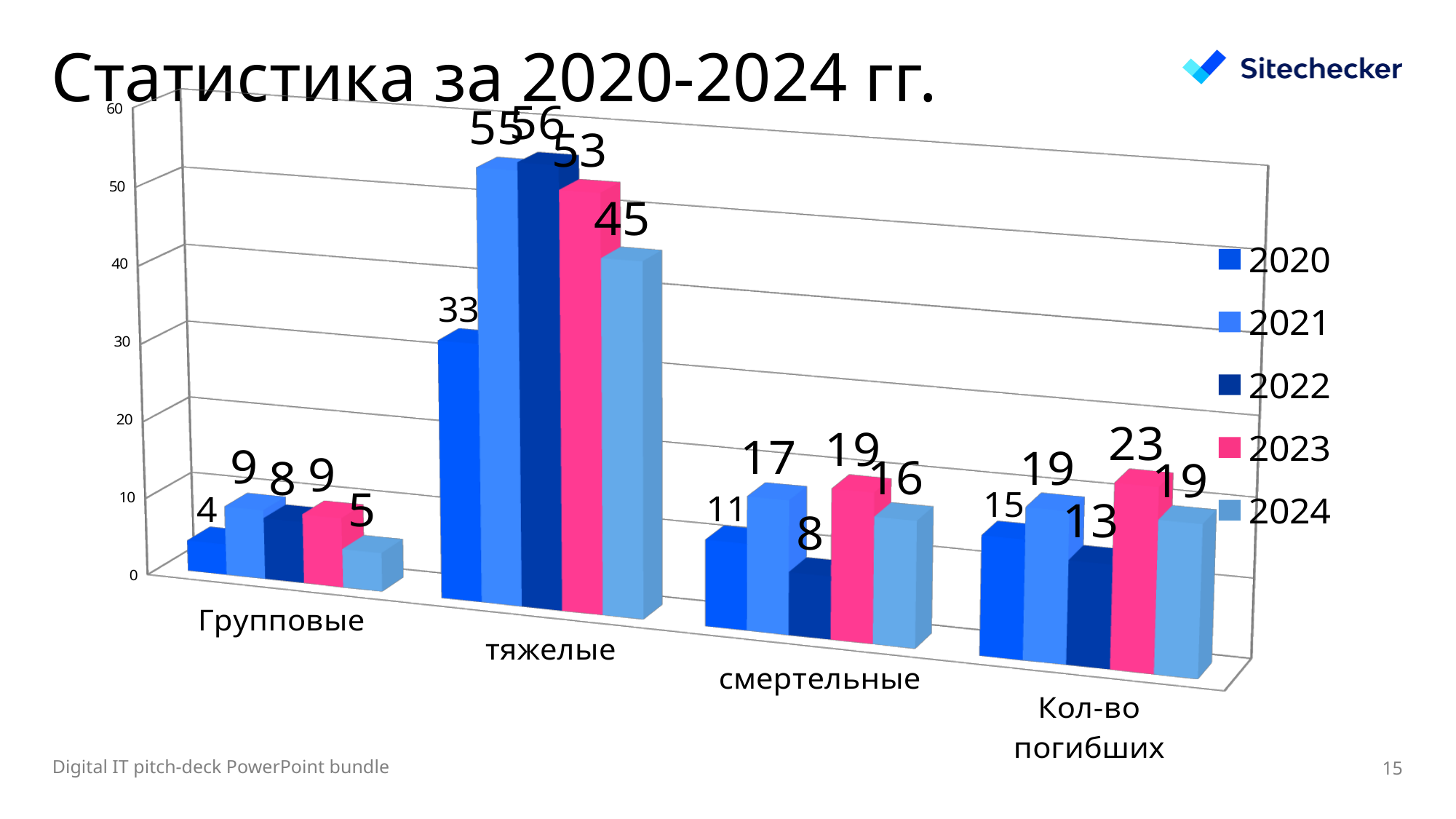
What is the value for 2023 in the Кол-во погибших category? 23 What is the value for 2020 in the Групповые category? 4 How many series does the legend list? 5 Which year has the lowest value in the смертельные category? 2022 What is the value for 2022 in the тяжелые category? 56 What is the title of the slide? Статистика за 2020-2024 гг. How many categories are shown on the x axis? 4 Which is larger in the Кол-во погибших category: the value for 2020 or the value for 2022? 2020 What is the value for 2024 in the смертельные category? 16 What is the difference between the 2021 and 2020 values in the тяжелые category? 22 What kind of chart is shown on the slide? Bar chart Which year has the highest value in the тяжелые category? 2022